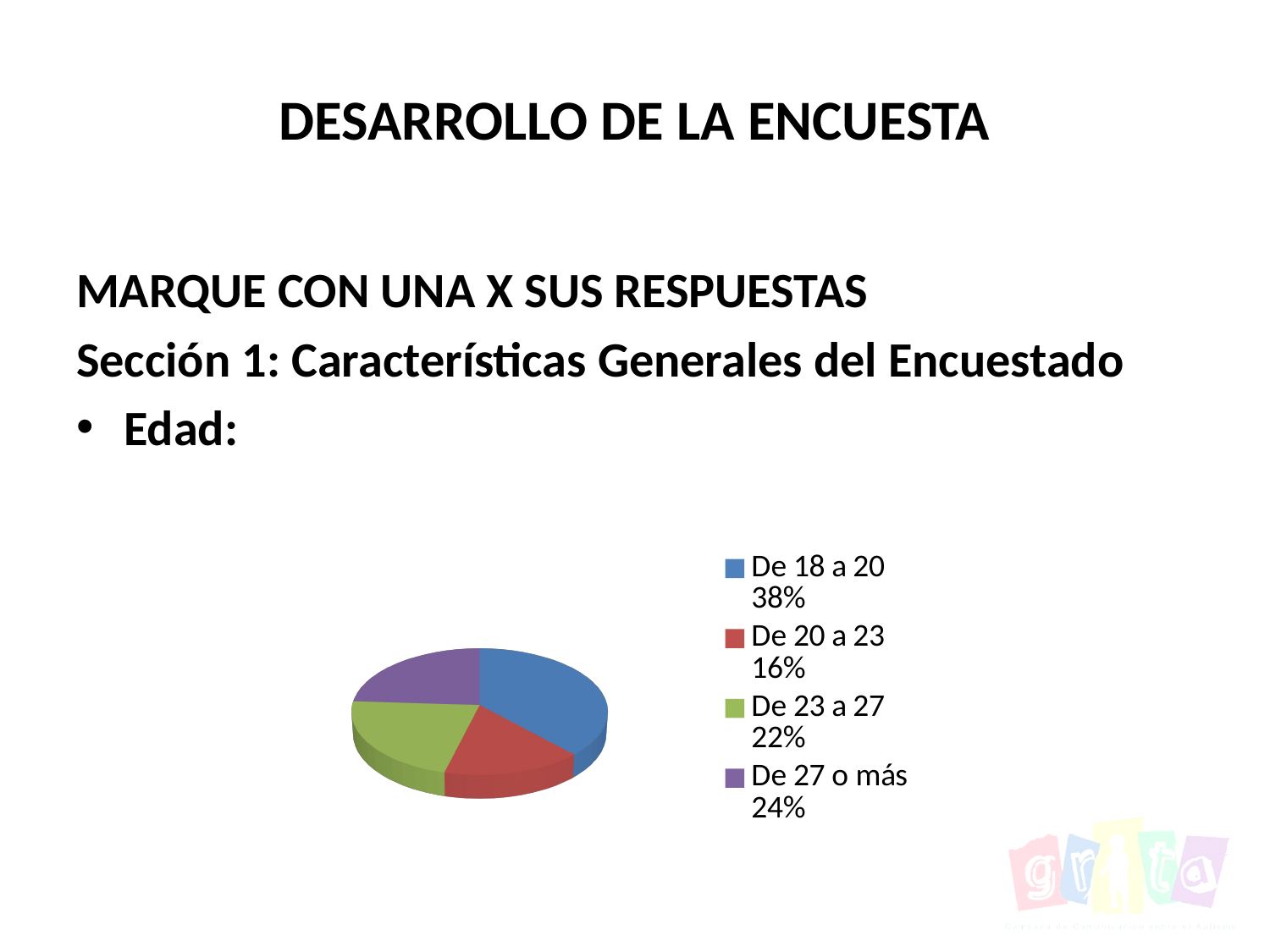
What kind of chart is shown on the slide? pie chart Which category has the smallest share of the pie? De 20 a 23 What colour represents the 'De 18 a 20' category in the pie chart? blue Which is larger, the share for 'De 27 o más' or the share for 'De 23 a 27'? De 27 o más What percentage is shown for the 'De 20 a 23' category? 16% What percentage is shown for the 'De 18 a 20' category? 38% What is the difference in percentage points between 'De 18 a 20' and 'De 20 a 23'? 22 What percentage is shown for the 'De 27 o más' category? 24% What percentage is shown for the 'De 23 a 27' category? 22% How many categories does the pie chart have? 4 Which category has the largest share of the pie? De 18 a 20 What colour represents the 'De 23 a 27' category in the pie chart? green